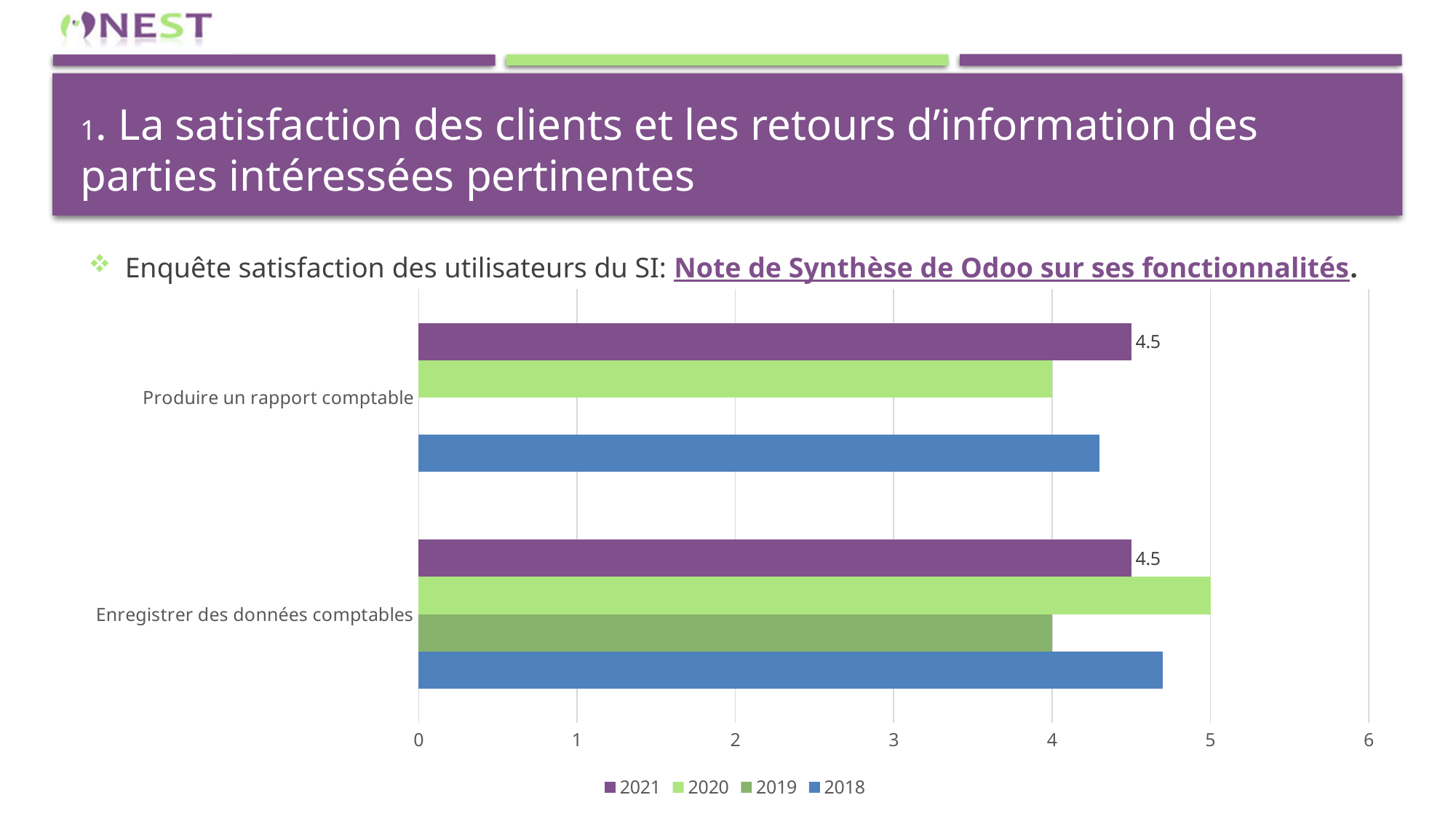
Is the value for 2018 for "Enregistrer des données comptables" greater or less than 5? less What is the value for 2021 for "Enregistrer des données comptables"? 4.5 What is the value for 2020 for "Enregistrer des données comptables"? 5 What is the value for 2021 for "Produire un rapport comptable"? 4.5 For "Enregistrer des données comptables", which series has the highest value? 2020 What is the value for 2020 for "Produire un rapport comptable"? 4 How many categories are shown on the chart? 2 For "Enregistrer des données comptables", what is the difference between the 2020 value and the 2021 value? 0.5 What kind of chart is shown on the slide? Bar chart How many series does the legend list? 4 What is the value for 2019 for "Enregistrer des données comptables"? 4 Is the value for 2018 for "Produire un rapport comptable" greater or less than 5? less